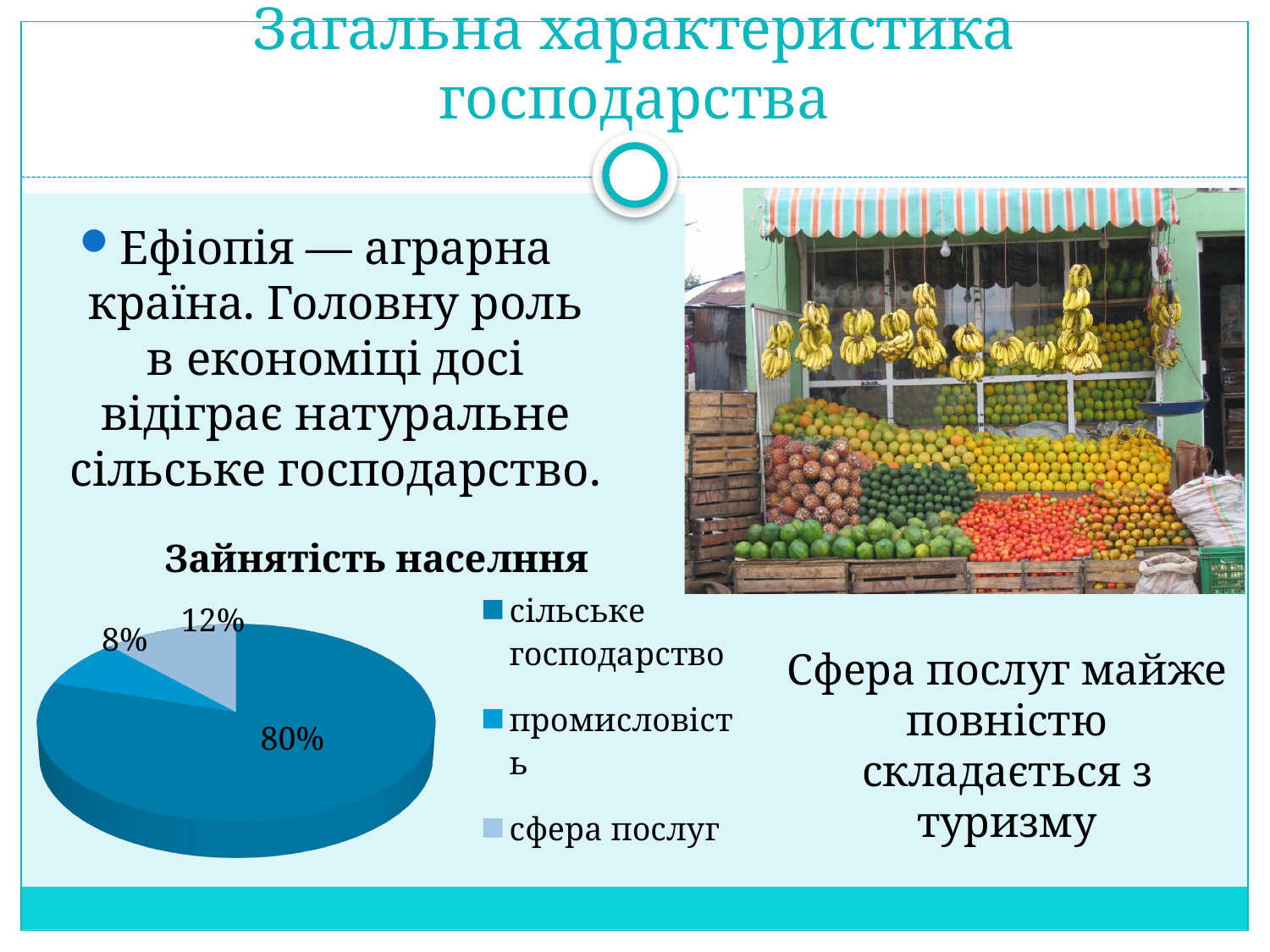
Which category has the smallest slice of the pie? промисловість How many categories does the pie chart show? 3 How many entries does the legend list? 3 Which is larger, the share of сфера послуг or the share of промисловість? сфера послуг What is the title of the chart? Зайнятість населння Which category has the largest slice of the pie? сільське господарство What is the difference between the shares of сфера послуг and промисловість? 4% What share of the pie does сільське господарство have? 80% What type of chart is shown on the slide? pie chart What share of the pie does сфера послуг have? 12% What share of the pie does промисловість have? 8% What is the difference between the shares of сільське господарство and сфера послуг? 68%